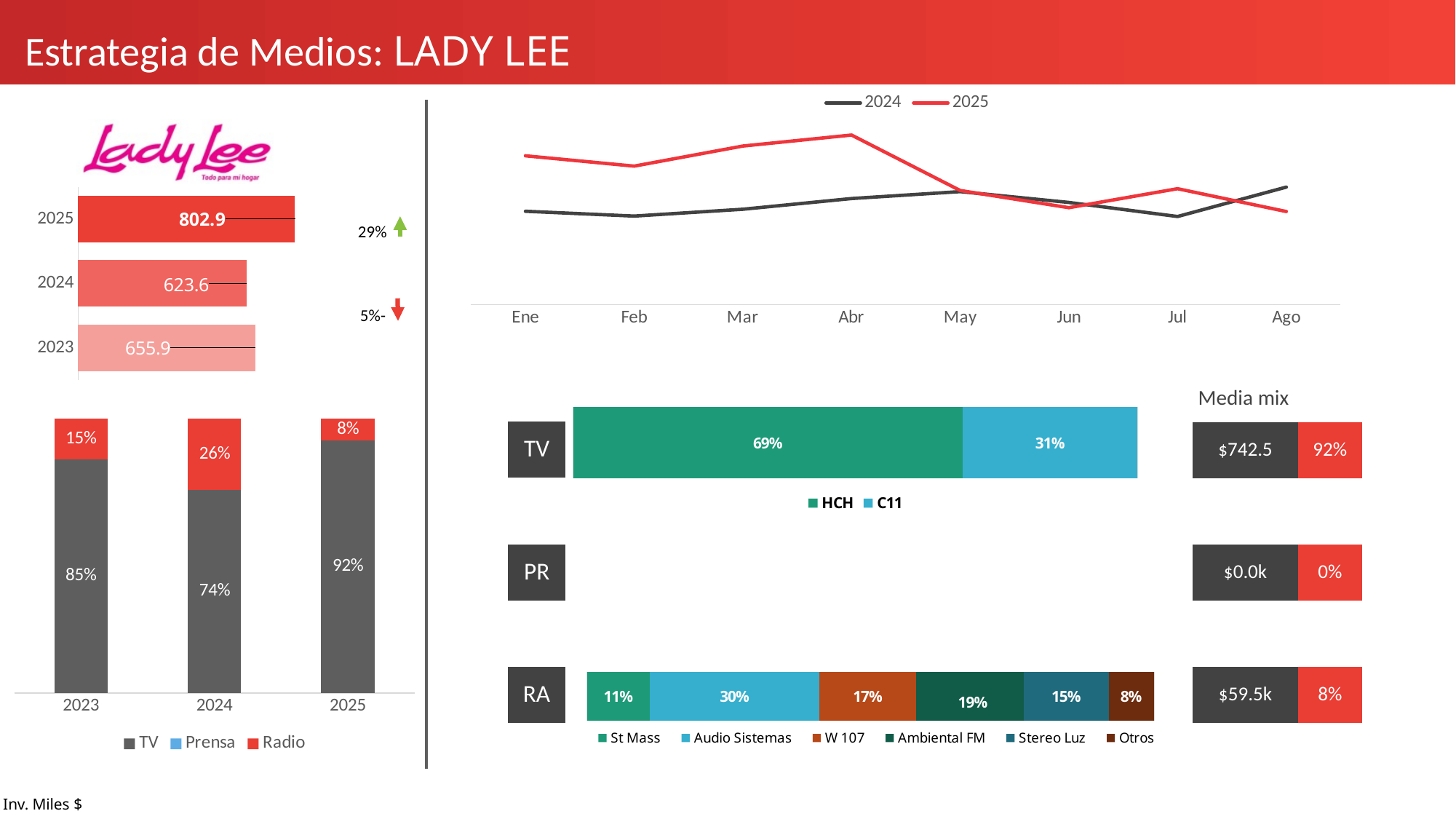
In the stacked bar chart at the bottom left, which year has the highest Radio share? 2024 In the line chart at the top right, how many months are shown on the x axis? 8 In the line chart at the top right, which series is higher in Abr, 2024 or 2025? 2025 How many series does the legend of the stacked bar chart at the bottom left list? 3 In the TV channel split bar on the right, what is the share for HCH? 69% In the yearly investment bar chart on the left, which year has the lowest value? 2024 In the yearly investment bar chart on the left, what is the difference between the 2025 and 2024 values? 179.3 In the line chart at the top right, does the 2025 line rise or fall from Abr to May? fall In the stacked bar chart at the bottom left, what is the TV share for 2024? 74% In the RA (radio) station split bar on the right, which station has the largest share? Audio Sistemas In the Media mix table on the right, what is the investment value shown for RA? $59.5k In the yearly investment bar chart on the left, what is the value for 2025? 802.9